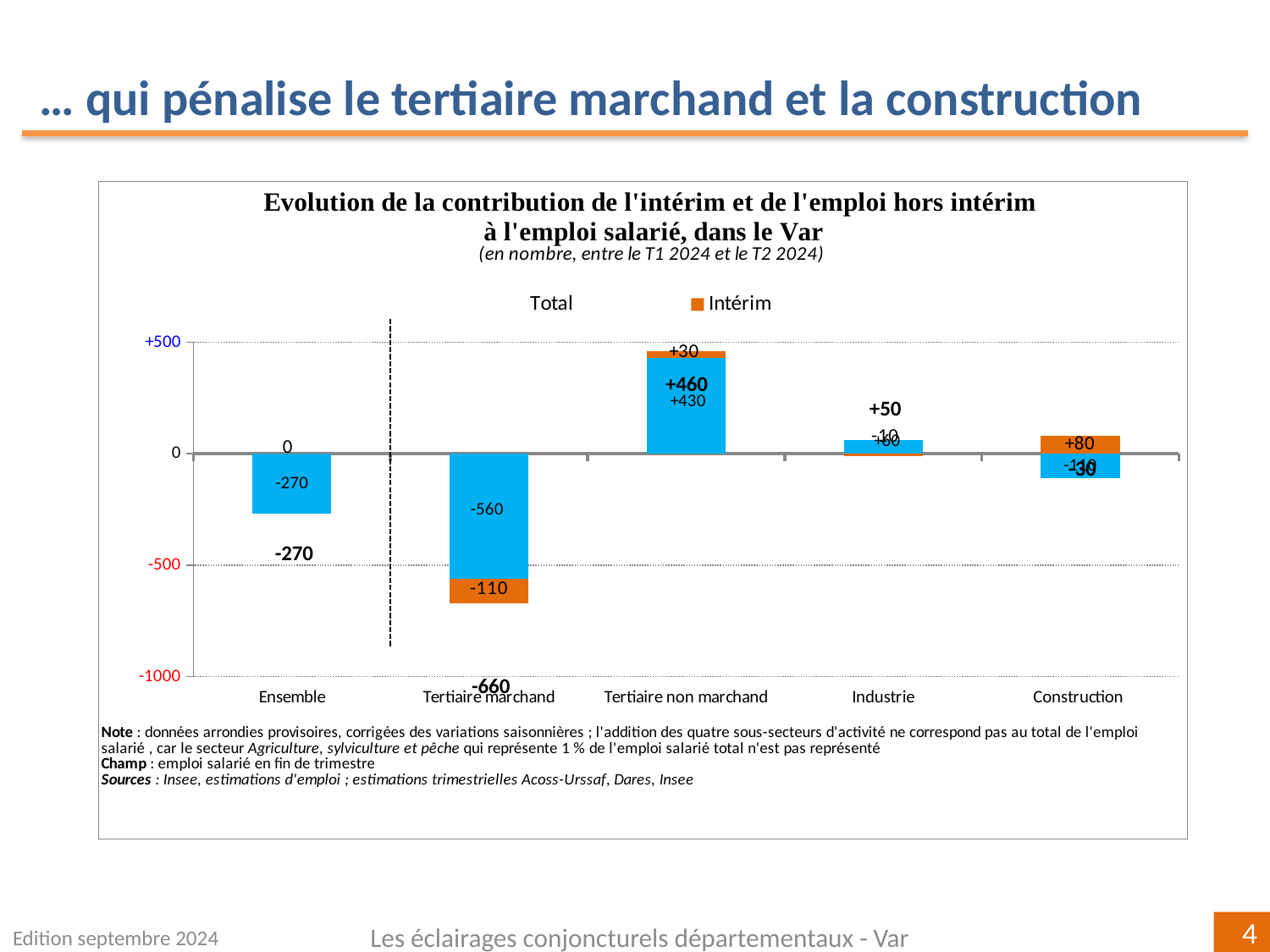
Which is larger, the Intérim value for Tertiaire marchand or the Intérim value for Tertiaire non marchand? Tertiaire non marchand Which colour represents the Intérim series in the chart? orange What is the difference between the total values for Tertiaire non marchand (+460) and Industrie (+50)? 410 Which category has the highest total value? Tertiaire non marchand What is the total value shown for Tertiaire non marchand? +460 How many series does the chart legend list? 2 How many sector categories are shown along the x axis of the chart? 5 What kind of chart is shown on the slide? bar chart What is the total value shown for Ensemble? -270 What is the total value shown for Tertiaire marchand? -660 Which category has the lowest total value? Tertiaire marchand What is the Intérim value for Tertiaire marchand? -110